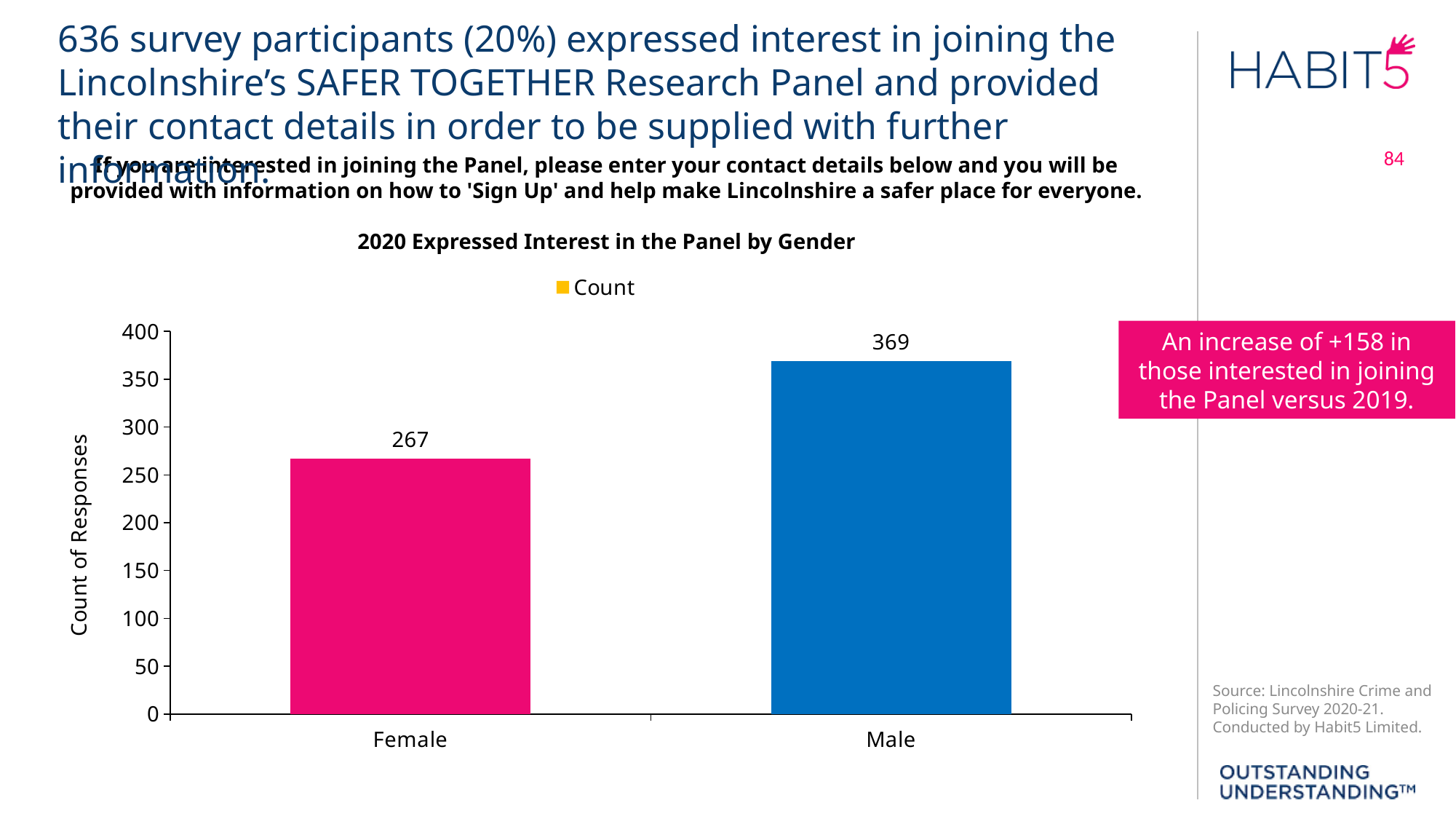
What is the count of responses for Female? 267 Is the count for Male greater or less than 350? greater How many series does the legend list? 1 Is the count for Female greater or less than 300? less What is the difference between the Male and Female counts? 102 What is the count of responses for Male? 369 How many categories are shown on the x axis? 2 What kind of chart is shown? bar chart Which gender has the higher count of responses? Male What is the label on the y axis? Count of Responses Which gender has the lower count of responses? Female What is the title of the chart? 2020 Expressed Interest in the Panel by Gender